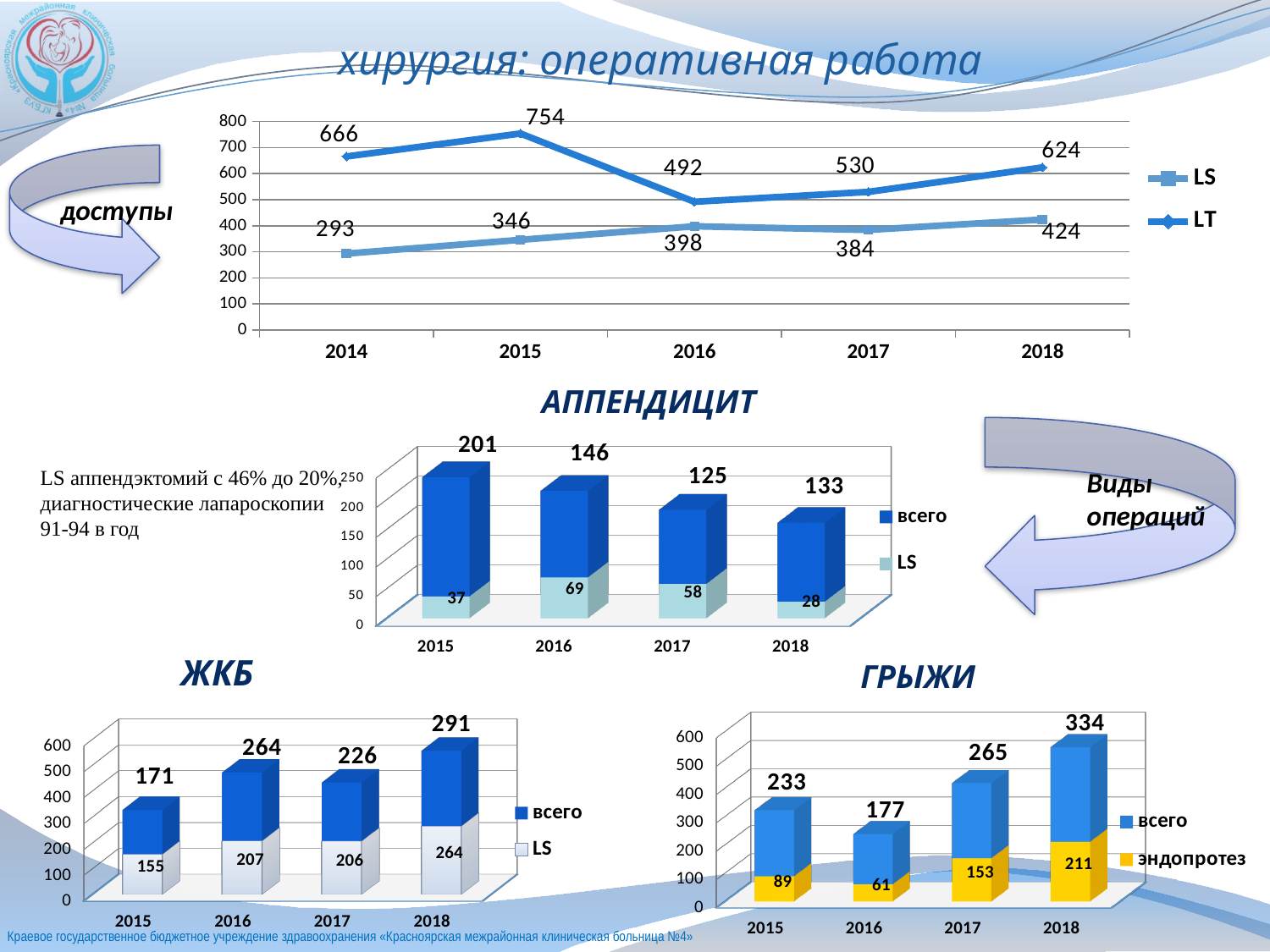
In the top line chart, what is the LS value for 2014? 293 In the ГРЫЖИ chart, what is the эндопротез value for 2017? 153 In the ЖКБ chart, which is larger, the LS value for 2016 or the LS value for 2017? 2016 In the top line chart, how many series does the legend list? 2 In the ГРЫЖИ chart, how many years are shown on the x axis? 4 In the ЖКБ chart, what is the всего value for 2018? 291 In the АППЕНДИЦИТ chart, what kind of chart is shown? bar chart In the АППЕНДИЦИТ chart, which year has the highest всего value? 2015 In the top line chart, what is the LT value for 2015? 754 In the top line chart, which year has the lowest LT value? 2016 In the АППЕНДИЦИТ chart, what is the LS value for 2016? 69 In the top line chart, what is the difference between the LT and LS values in 2018? 200